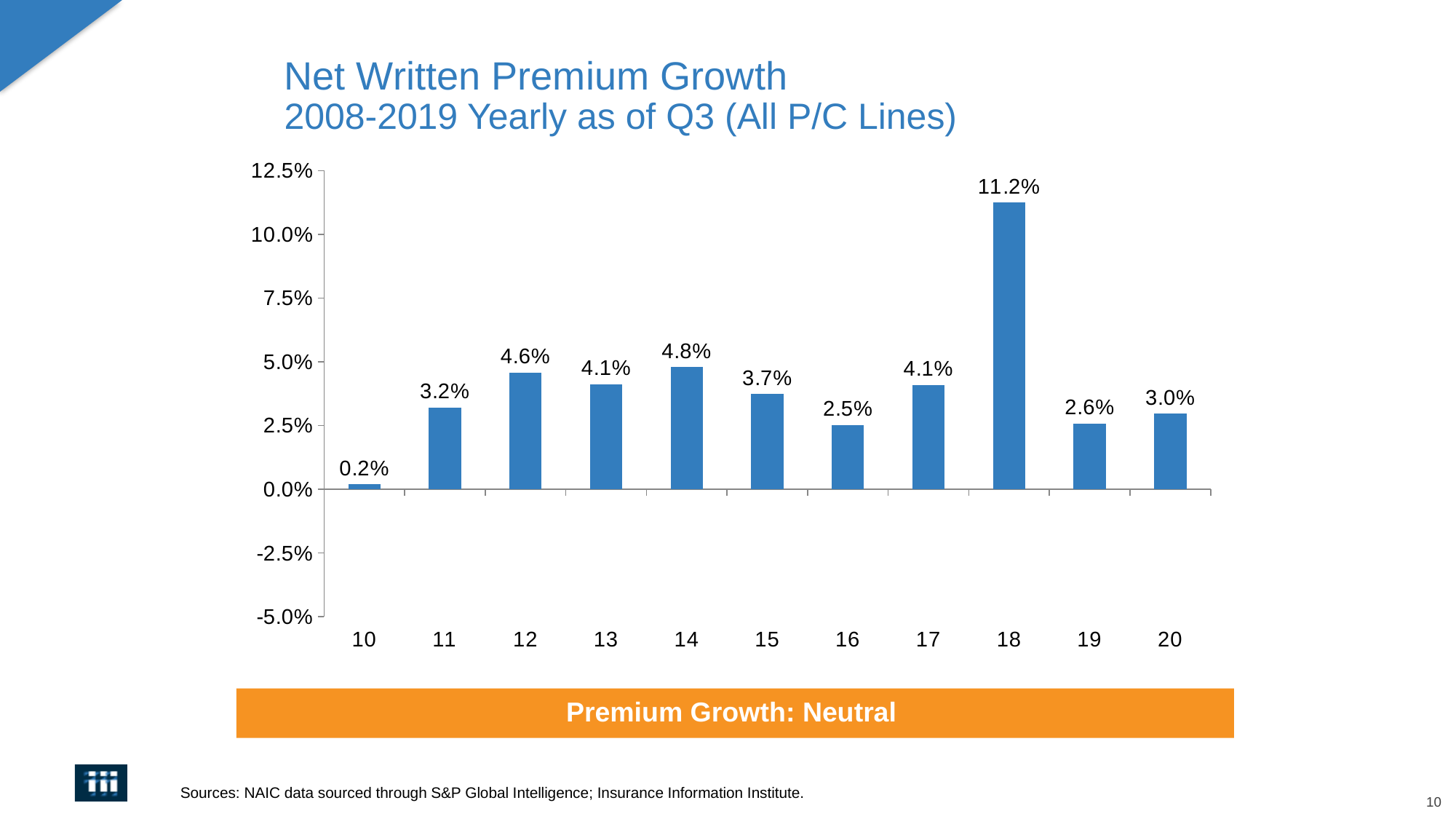
Which year has the highest net written premium growth? 18 What is the value shown for 14? 4.8% Which is larger, the value for 12 or the value for 15? 12 What kind of chart is shown on the slide? Bar chart Do the values rise or fall from 18 to 19? Fall What is the value shown for 10? 0.2% What is the difference between the values for 18 and 19? 8.6% How many years are shown on the x axis? 11 What does the orange banner below the chart say? Premium Growth: Neutral What is the net written premium growth value for 18? 11.2% Is the value for 18 greater or less than 10.0%? greater Which year has the lowest net written premium growth? 10